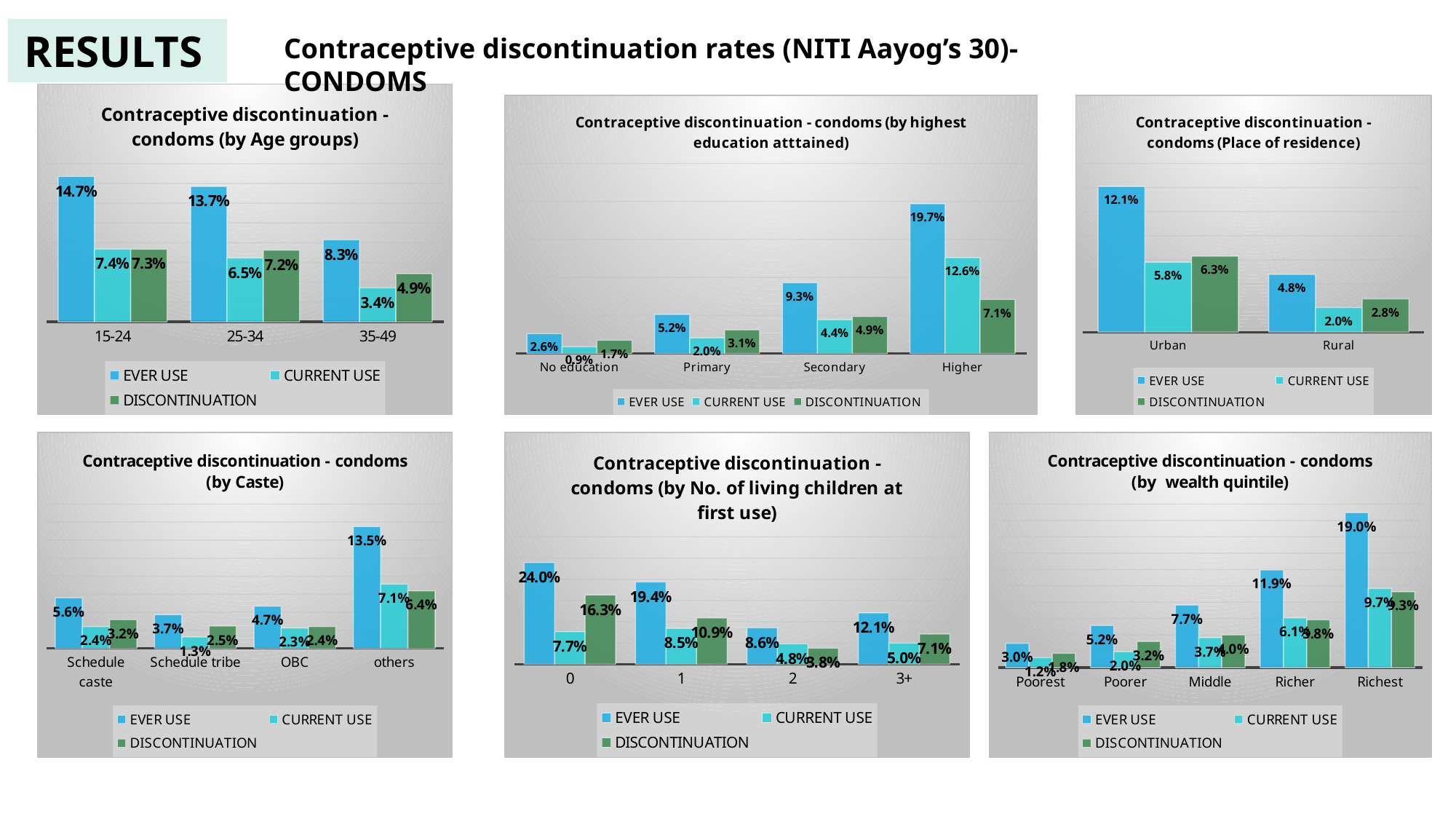
What kind of chart is the 'Contraceptive discontinuation - condoms (by wealth quintile)' chart? Bar chart In the 'Contraceptive discontinuation - condoms (by No. of living children at first use)' chart, how many series does the legend list? 3 In the 'Contraceptive discontinuation - condoms (Place of residence)' chart, what is the difference between the EVER USE values for Urban and Rural? 7.3% In the 'Contraceptive discontinuation - condoms (by Age groups)' chart, which age group has the lowest DISCONTINUATION value? 35-49 In the 'Contraceptive discontinuation - condoms (by Caste)' chart, which caste category has the highest EVER USE value? others In the 'Contraceptive discontinuation - condoms (by highest education atttained)' chart, what is the CURRENT USE value for Higher education? 12.6% In the 'Contraceptive discontinuation - condoms (by Caste)' chart, what is the CURRENT USE value for Schedule tribe? 1.3% In the 'Contraceptive discontinuation - condoms (Place of residence)' chart, which is larger, the DISCONTINUATION value for Urban or for Rural? Urban In the 'Contraceptive discontinuation - condoms (by Age groups)' chart, what is the EVER USE value for the 15-24 age group? 14.7% In the 'Contraceptive discontinuation - condoms (by highest education atttained)' chart, how many education categories are shown on the x axis? 4 In the 'Contraceptive discontinuation - condoms (by No. of living children at first use)' chart, what is the DISCONTINUATION value for 0 children? 16.3% In the 'Contraceptive discontinuation - condoms (by wealth quintile)' chart, what is the EVER USE value for the Richest quintile? 19.0%